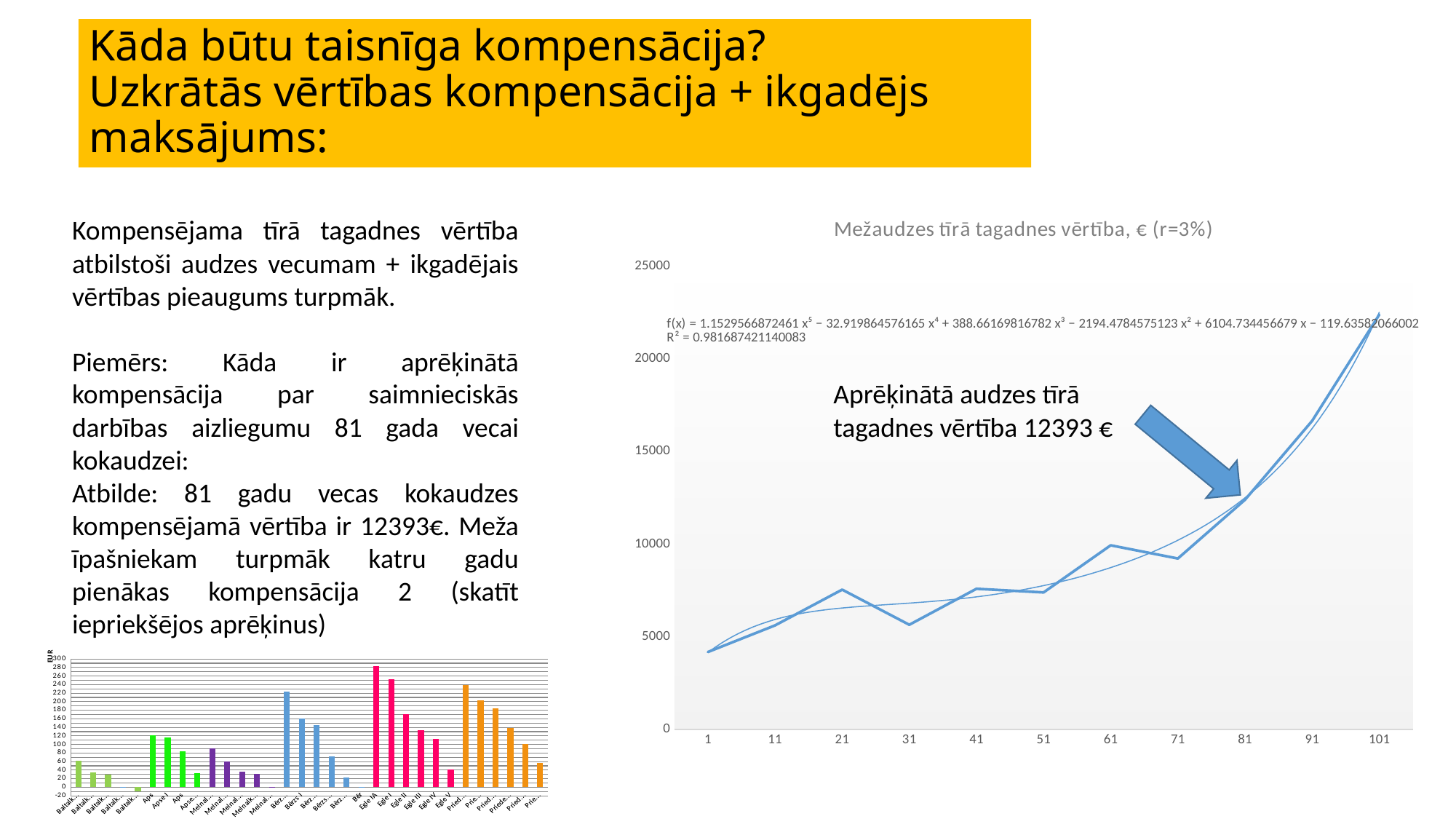
In the line chart on the right, do the values overall rise or fall from x = 1 to x = 101? rise In the line chart on the right, is the value at x = 1 greater or less than 5000? less In the line chart on the right, is the value at x = 31 greater or less than 10000? less What kind of chart is the chart titled 'Mežaudzes tīrā tagadnes vērtība, € (r=3%)'? line chart In the line chart on the right, which has the larger value: x = 21 or x = 31? x = 21 In the line chart on the right, at which x-axis value is the plotted value highest? 101 In the line chart on the right, what is the calculated net present value annotated at age 81? 12393 € In the bar chart at the bottom left of the slide, is the tallest bar greater or less than 250? greater What is the title of the line chart on the right of the slide? Mežaudzes tīrā tagadnes vērtība, € (r=3%) In the line chart on the right, what is the R² value shown for the trendline? 0.981687421140083 In the line chart on the right, at which x-axis value is the plotted value lowest? 1